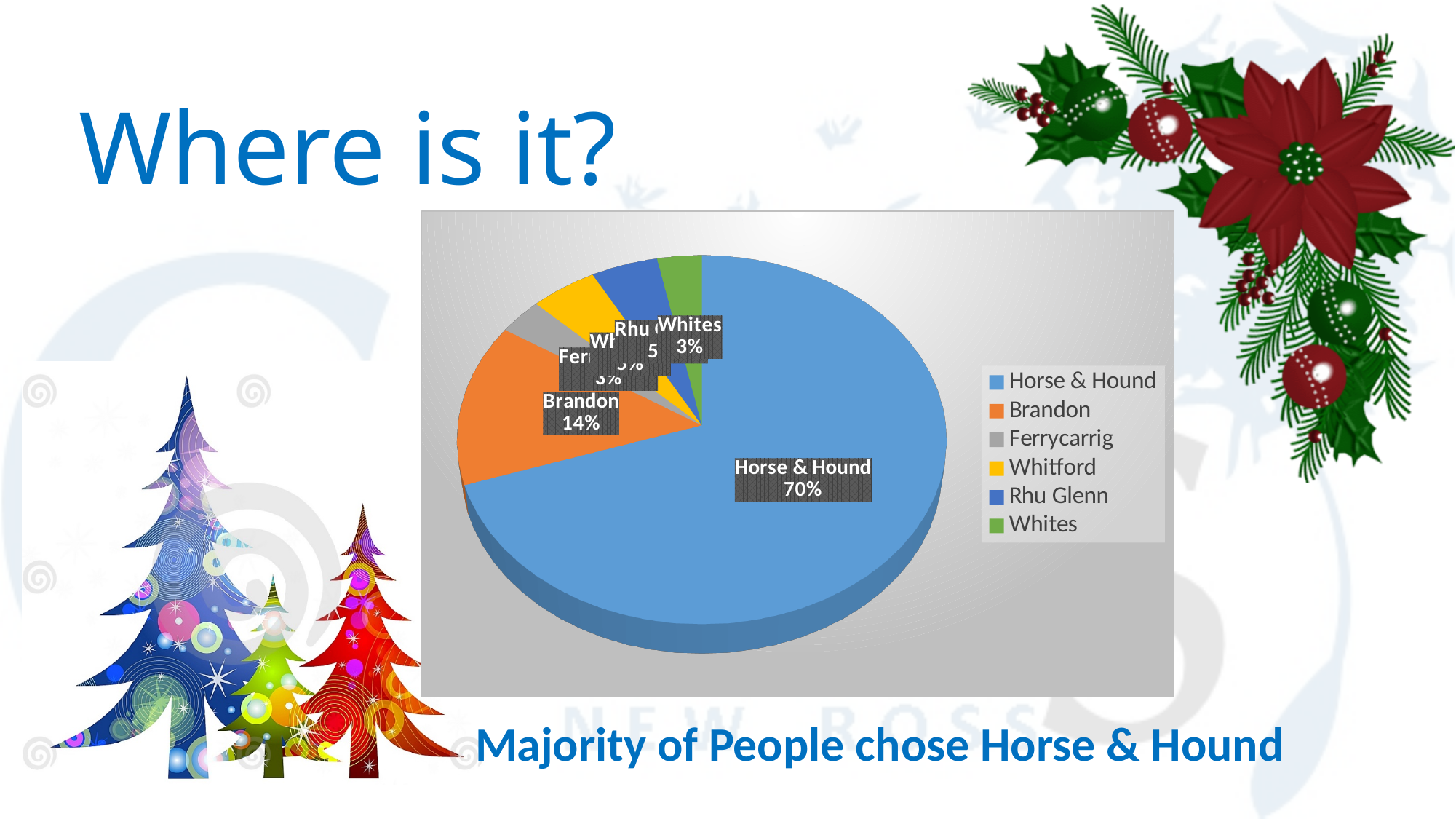
What percentage of people chose Brandon? 14% How many venues are listed in the chart legend? 6 What is the difference in percentage points between Brandon and Whites? 11% What percentage of people chose Whites? 3% What percentage of people chose Horse & Hound? 70% What is the difference in percentage points between Horse & Hound and Brandon? 56% Which venue has the largest share of the pie? Horse & Hound Which has a larger share, Horse & Hound or Brandon? Horse & Hound Which has a larger share, Brandon or Whites? Brandon What colour is the Horse & Hound slice in the pie chart? blue What kind of chart is shown on the slide? pie chart What is the last venue listed in the chart legend? Whites